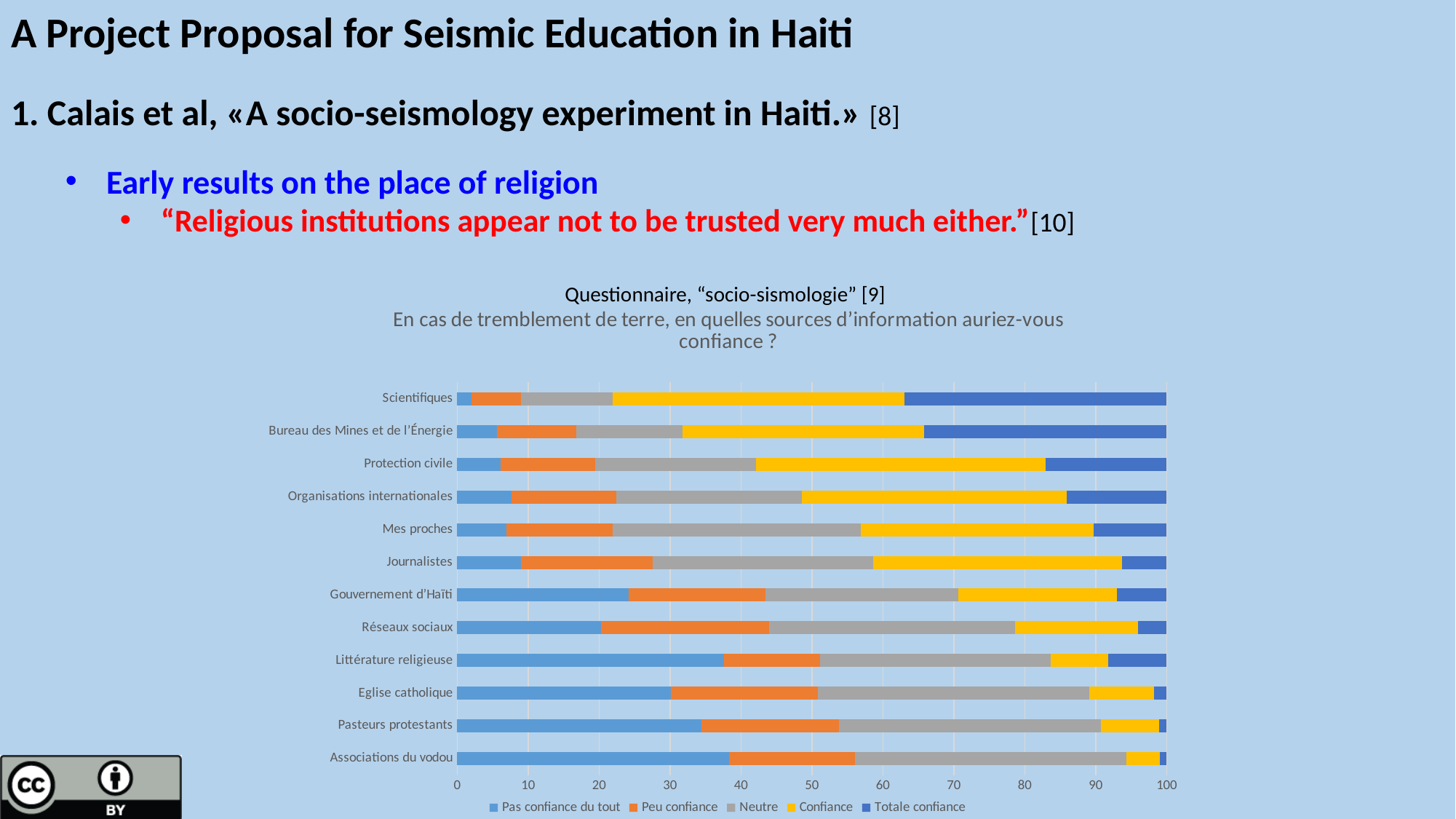
Which category has the smallest 'Pas confiance du tout' segment? Scientifiques Which has the larger 'Pas confiance du tout' value, Gouvernement d'Haïti or Scientifiques? Gouvernement d'Haïti How many categories (information sources) are listed on the chart's vertical axis? 12 What kind of chart is shown on the slide? Stacked bar chart Is the 'Totale confiance' value for Scientifiques greater or less than 30? greater Which colour represents the 'Neutre' series in the chart's legend? Grey Is the 'Totale confiance' value for Pasteurs protestants greater or less than 10? less How many series does the chart's legend list? 5 Is the 'Pas confiance du tout' value for Associations du vodou greater or less than 30? greater Which has the larger 'Totale confiance' value, Scientifiques or Eglise catholique? Scientifiques What is the total of the stacked bar for Scientifiques, as read on the horizontal axis? 100